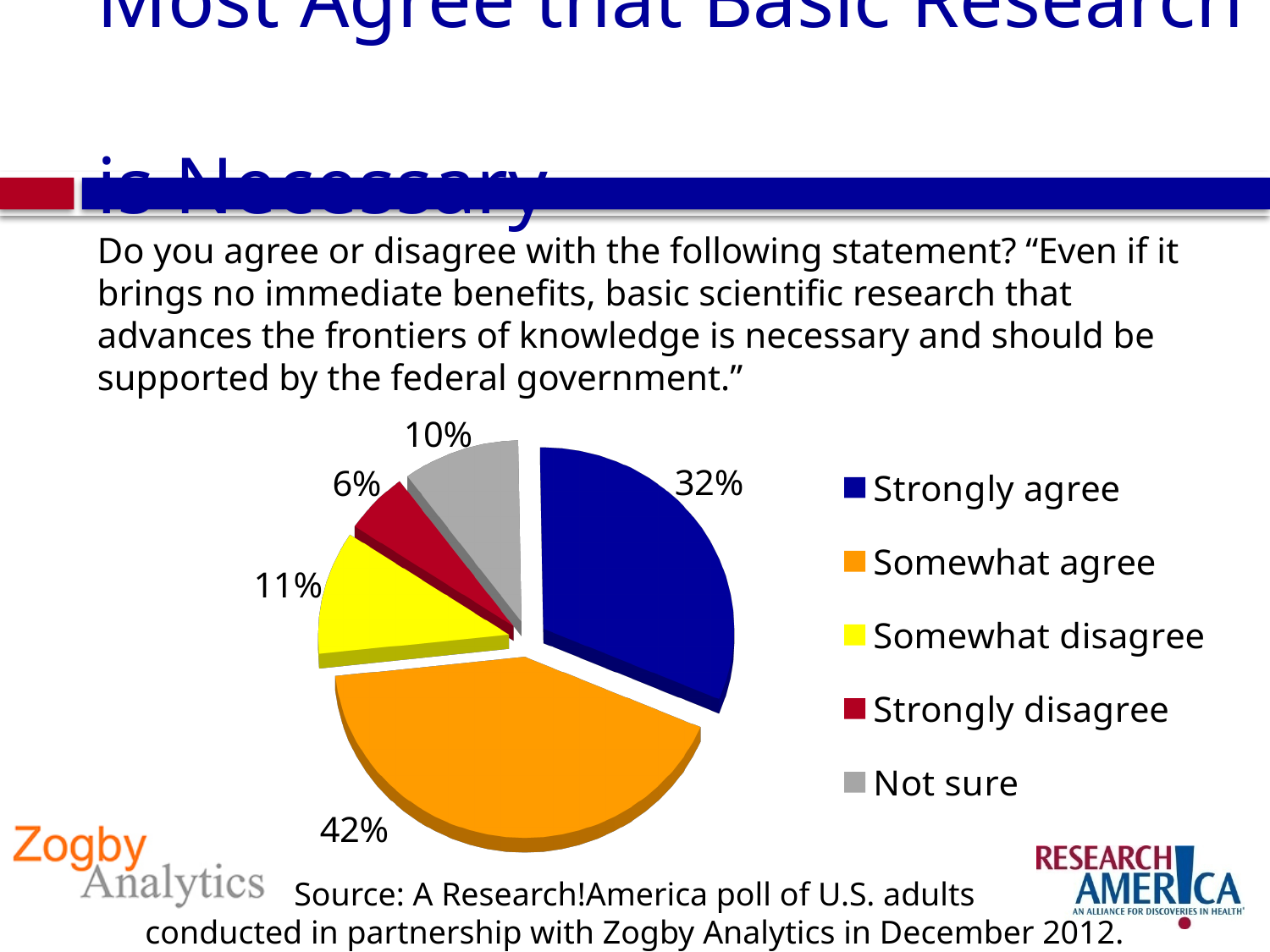
How many categories does the legend list? 5 What percentage of respondents were not sure? 10% Which response category has the smallest share of the pie? Strongly disagree Which is larger, the share for Somewhat disagree or the share for Not sure? Somewhat disagree What percentage of respondents said they strongly agree? 32% What colour is the Strongly agree slice? dark blue What kind of chart is shown on the slide? pie chart What percentage of respondents said they strongly disagree? 6% What is the difference in percentage points between Somewhat agree and Strongly agree? 10 What percentage of respondents said they somewhat agree? 42% Which response category has the largest share of the pie? Somewhat agree What percentage of respondents said they somewhat disagree? 11%